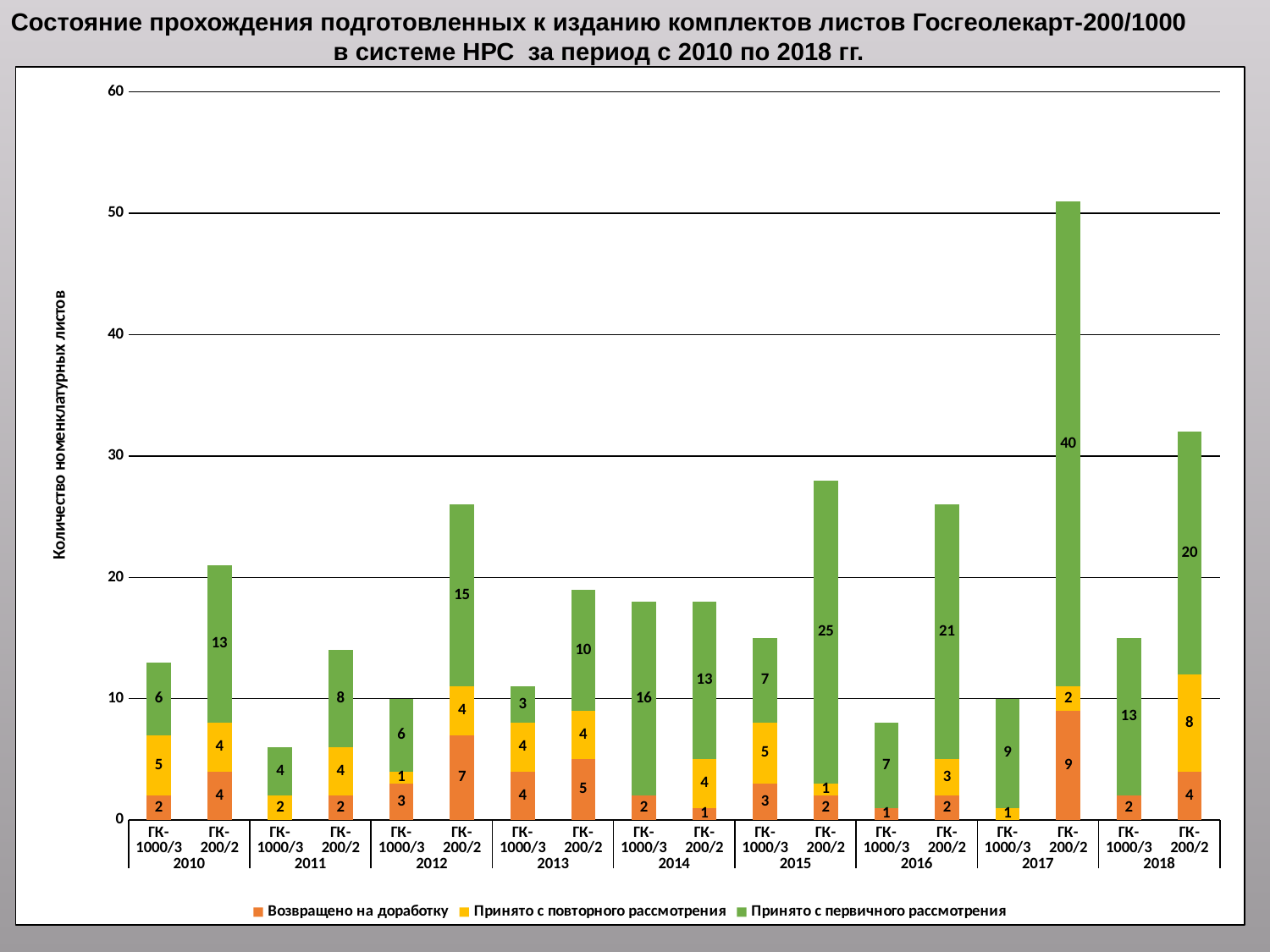
What is the difference between the 'Принято с первичного рассмотрения' values for ГК-200/2 in 2015 and ГК-200/2 in 2016? 4 What is the value of 'Принято с первичного рассмотрения' for ГК-200/2 in 2017? 40 Which bar is the tallest in the chart? ГК-200/2 in 2017 Which bar is the shortest in the chart? ГК-1000/3 in 2011 How many series does the legend list? 3 Which has a larger 'Принято с повторного рассмотрения' value: ГК-200/2 in 2018 or ГК-1000/3 in 2010? ГК-200/2 in 2018 What is the total of the stacked bar for ГК-1000/3 in 2010? 13 What is the value of 'Возвращено на доработку' for ГК-200/2 in 2012? 7 What is the total of the stacked bar for ГК-200/2 in 2017? 51 What kind of chart is shown on the slide? stacked bar chart What is the value of 'Принято с первичного рассмотрения' for ГК-1000/3 in 2014? 16 Is the total for ГК-200/2 in 2017 greater or less than 50? greater